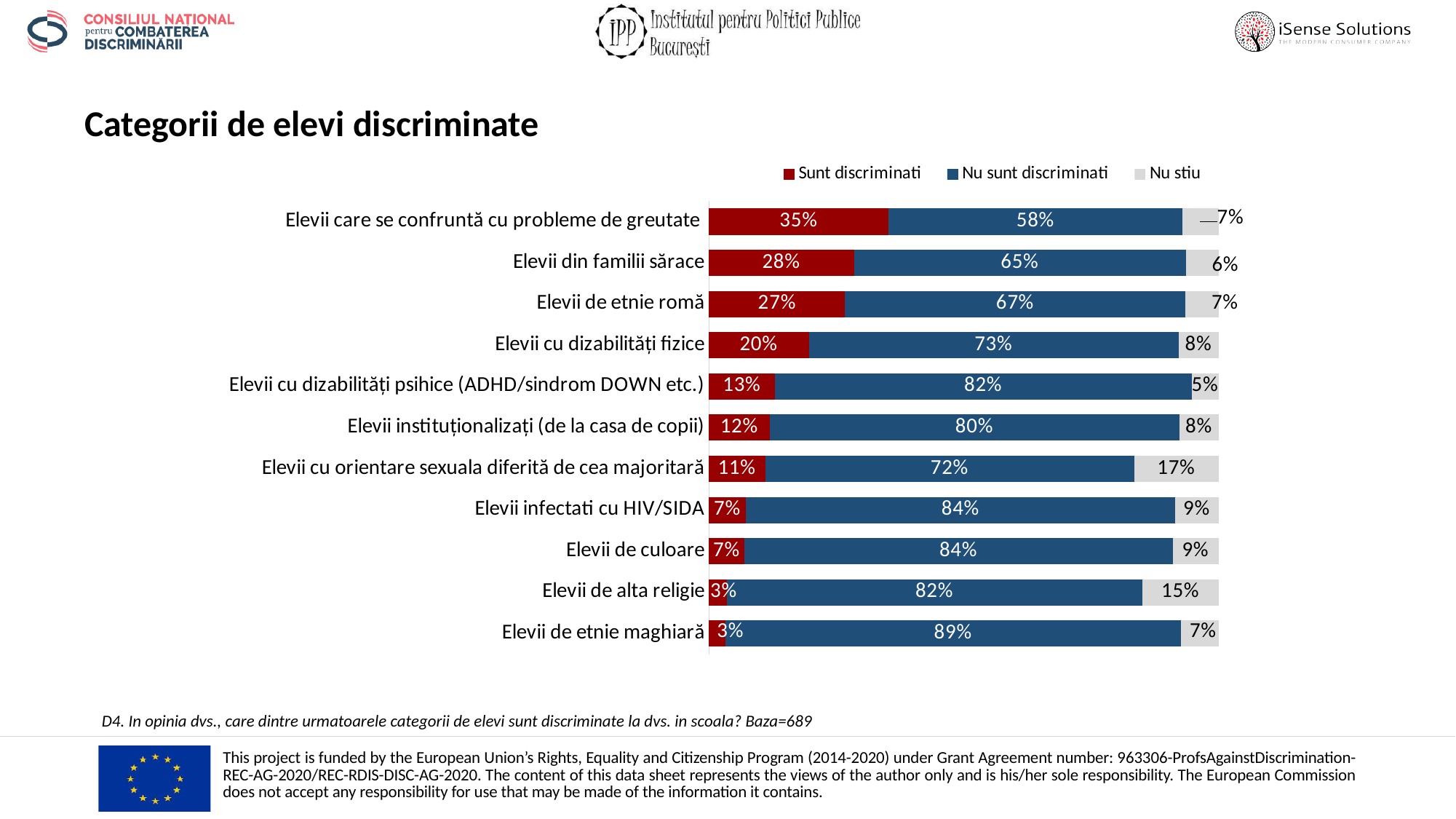
How many series does the legend list? 3 What kind of chart is shown on the slide? Stacked bar chart What is the 'Nu sunt discriminati' value for 'Elevii de etnie romă'? 67% What percentage of respondents said 'Sunt discriminati' for 'Elevii care se confruntă cu probleme de greutate'? 35% How many categories of students are shown in the chart? 11 Which is larger: the 'Nu stiu' value for 'Elevii de alta religie' or for 'Elevii de culoare'? Elevii de alta religie What is the title of the chart on the slide? Categorii de elevi discriminate What is the 'Nu stiu' value for 'Elevii cu orientare sexuala diferită de cea majoritară'? 17% Which category has the highest 'Nu sunt discriminati' value? Elevii de etnie maghiară What is the difference between the 'Sunt discriminati' values for 'Elevii din familii sărace' and 'Elevii cu dizabilități fizice'? 8% Which category has the lowest 'Nu sunt discriminati' value? Elevii care se confruntă cu probleme de greutate Which category has the highest 'Sunt discriminati' value? Elevii care se confruntă cu probleme de greutate